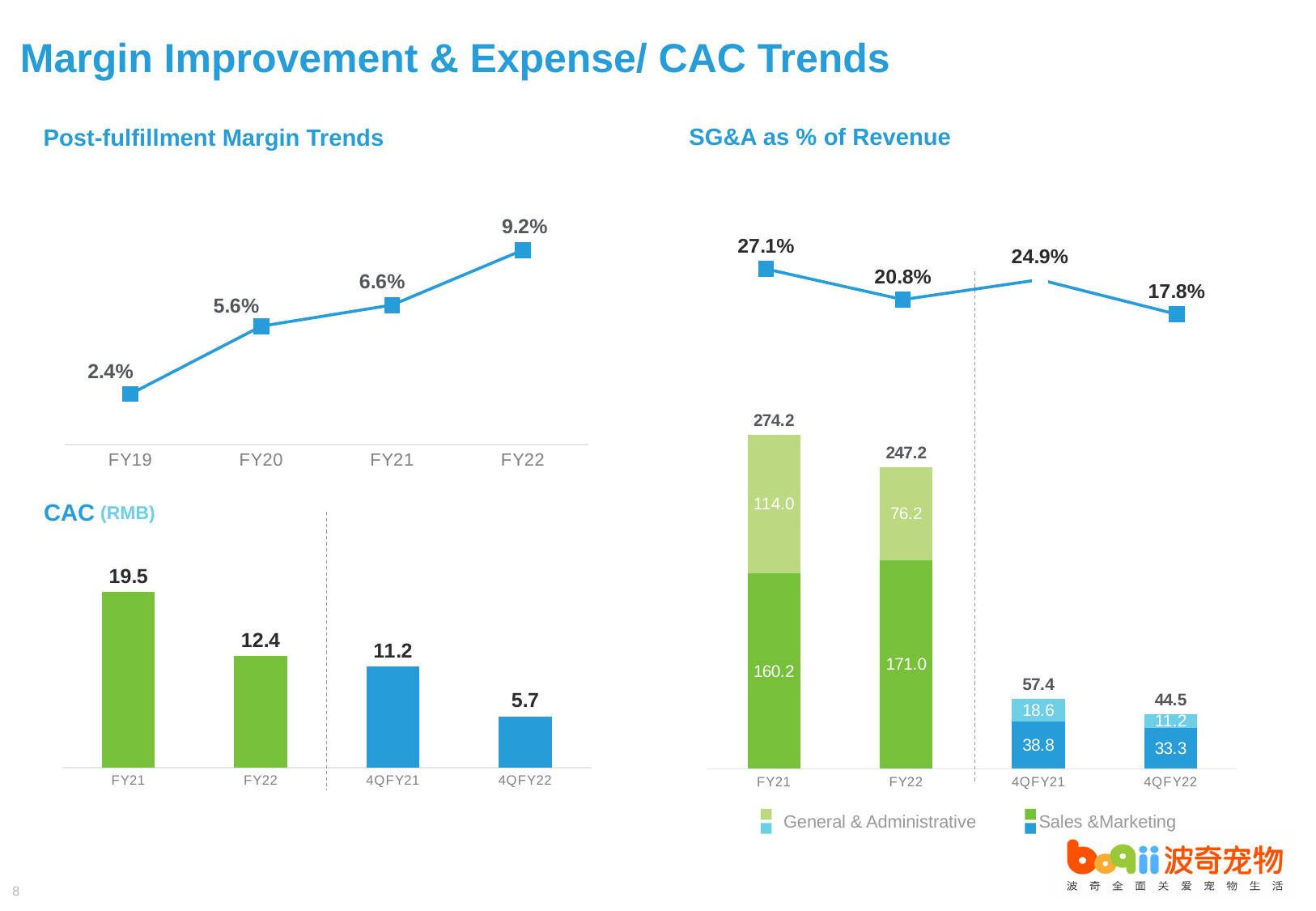
In the Post-fulfillment Margin Trends chart, what is the value for FY22? 9.2% How many series does the legend of the SG&A as % of Revenue chart list? 2 In the CAC (RMB) chart, what is the difference between FY21 and FY22? 7.1 What kind of chart is the CAC (RMB) chart? bar chart In the SG&A as % of Revenue chart, what is the total of the stacked bar for 4QFY21? 57.4 In the SG&A as % of Revenue chart, what is the Sales & Marketing value for FY22? 171.0 In the Post-fulfillment Margin Trends chart, what is the difference between the FY22 and FY19 values? 6.8% In the SG&A as % of Revenue chart, which is larger: the General & Administrative value for FY21 or for FY22? FY21 In the Post-fulfillment Margin Trends chart, do the values rise or fall from FY19 to FY22? rise In the Post-fulfillment Margin Trends chart, which fiscal year has the lowest margin? FY19 In the CAC (RMB) chart, what is the value for 4QFY22? 5.7 In the CAC (RMB) chart, which period has the highest CAC? FY21